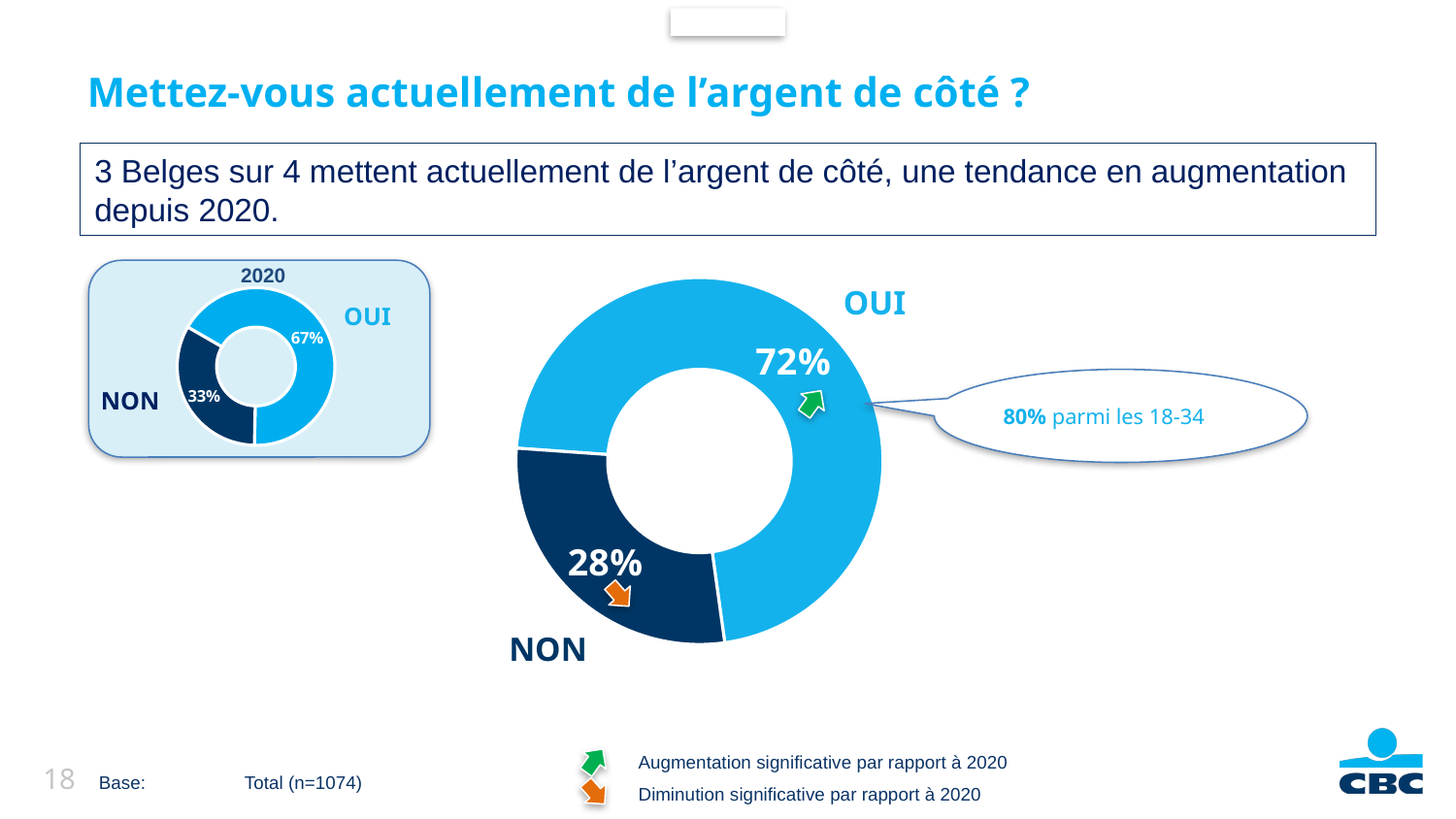
In the small 2020 donut chart, which category has the smallest share? NON In the large donut chart, what is the value for OUI? 72% What is the difference between the OUI value in the large donut chart and the OUI value in the small 2020 donut chart? 5% In the small 2020 donut chart, what is the value for OUI? 67% Which is larger: NON in the small 2020 donut chart or NON in the large donut chart? NON in the 2020 chart What year is shown as the title of the small donut chart on the left? 2020 In the large donut chart, which category has the largest share? OUI In the large donut chart, what is the difference between OUI and NON? 44% How many categories does the large donut chart show? 2 In the large donut chart, what is the value for NON? 28% What type of chart is the large chart in the centre of the slide? Donut (pie) chart In the small 2020 donut chart, what is the value for NON? 33%